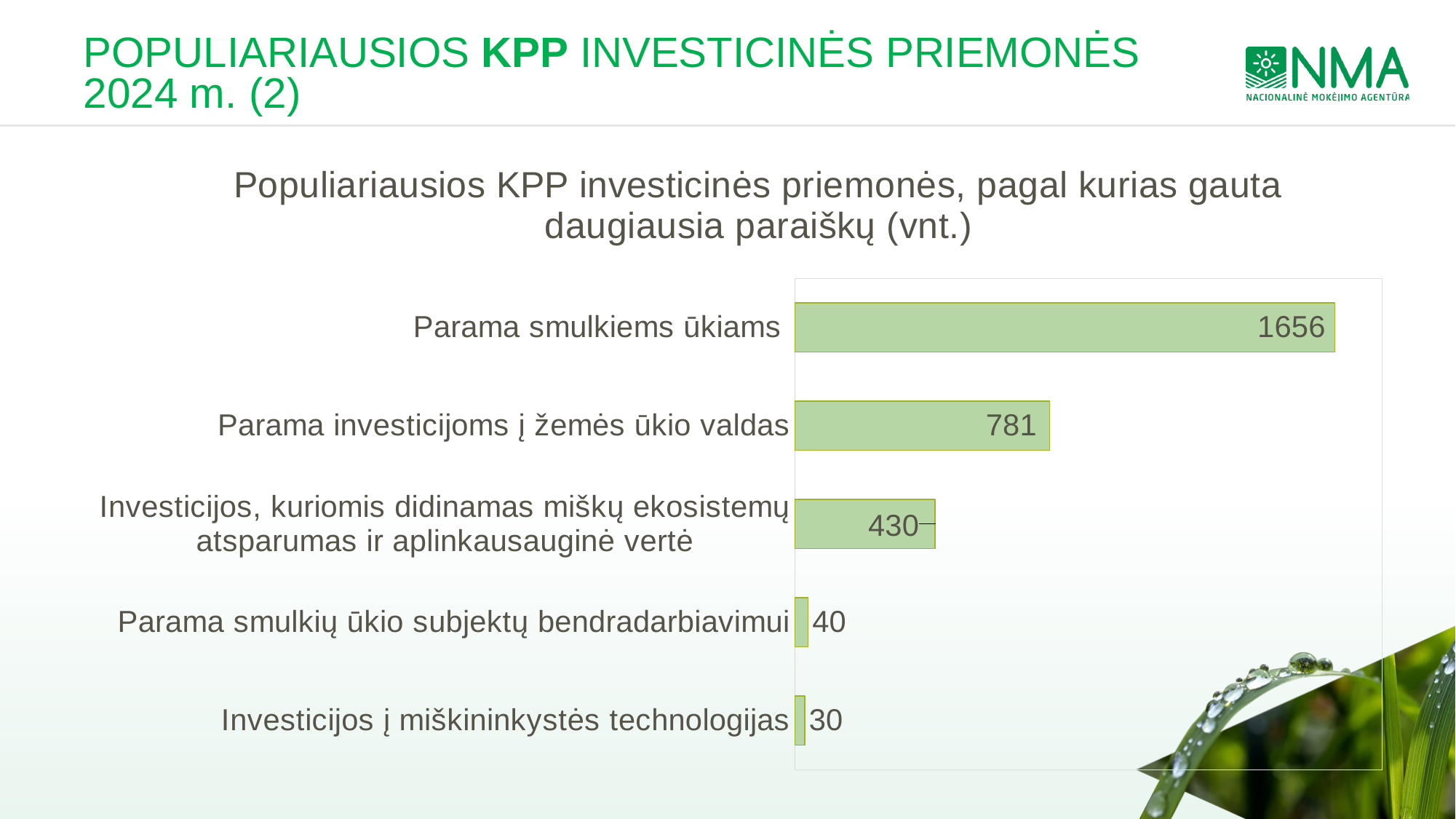
What is the value for Investicijos į miškininkystės technologijas? 30 What is the value for Parama smulkių ūkio subjektų bendradarbiavimui? 40 Which category has the lowest value? Investicijos į miškininkystės technologijas What is the value for Parama smulkiems ūkiams? 1656 What kind of chart is shown on the slide? Bar chart Which is larger: the value for Parama investicijoms į žemės ūkio valdas or the value for Investicijos, kuriomis didinamas miškų ekosistemų atsparumas ir aplinkausauginė vertė? Parama investicijoms į žemės ūkio valdas What is the title of the chart? Populiariausios KPP investicinės priemonės, pagal kurias gauta daugiausia paraiškų (vnt.) Which category has the highest value? Parama smulkiems ūkiams What is the value for Investicijos, kuriomis didinamas miškų ekosistemų atsparumas ir aplinkausauginė vertė? 430 What is the difference between the values for Parama smulkiems ūkiams and Parama investicijoms į žemės ūkio valdas? 875 What is the value for Parama investicijoms į žemės ūkio valdas? 781 How many categories are shown in the chart? 5